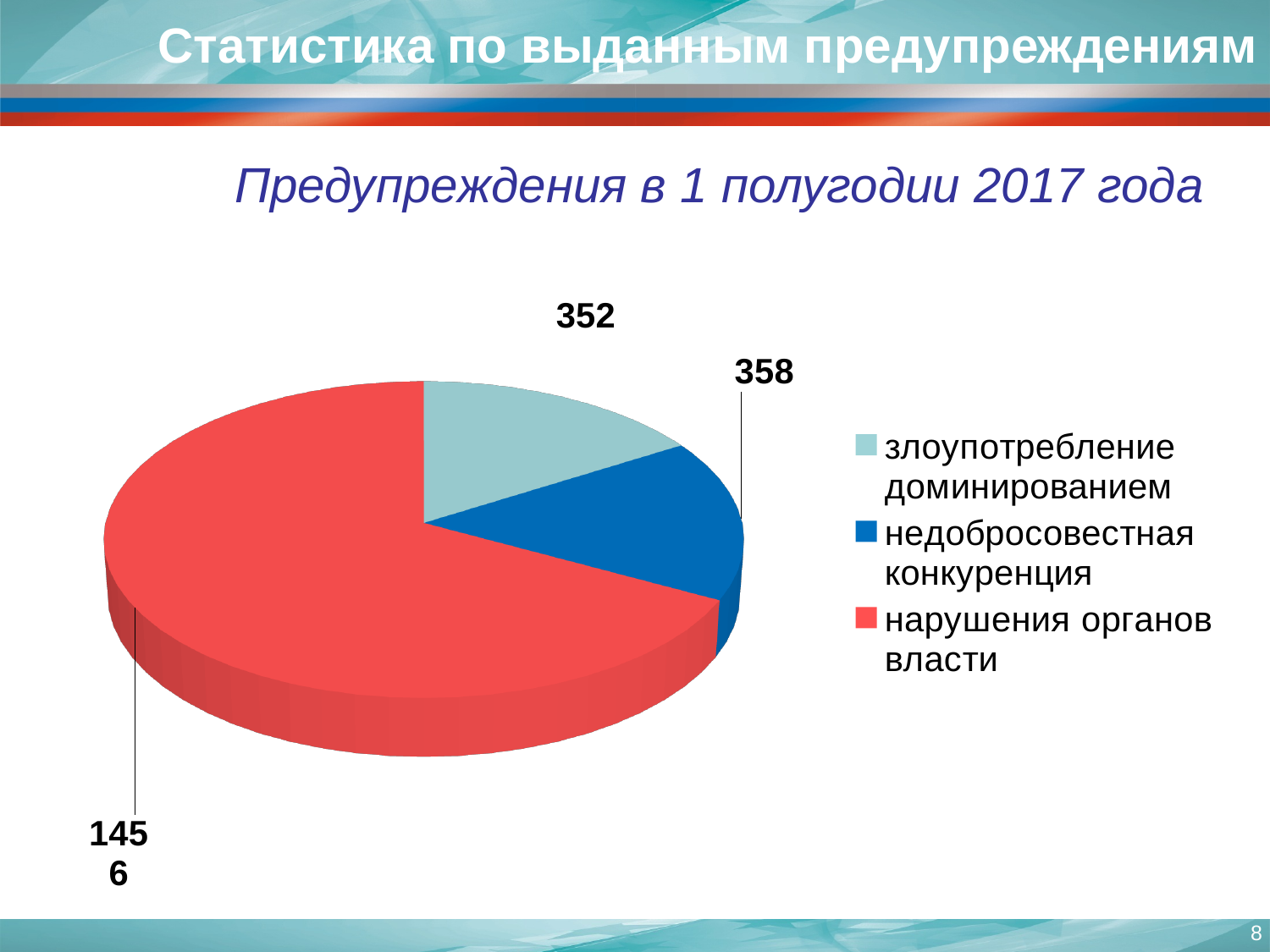
What is the value for недобросовестная конкуренция? 358 Which is larger: недобросовестная конкуренция or злоупотребление доминированием? недобросовестная конкуренция What is the value for нарушения органов власти? 1456 Which category has the largest slice of the pie? нарушения органов власти What is the value for злоупотребление доминированием? 352 What is the title of the chart? Предупреждения в 1 полугодии 2017 года Which category has the smallest value? злоупотребление доминированием How many entries does the legend list? 3 How many slices does the pie chart have? 3 What is the difference between the values for недобросовестная конкуренция and злоупотребление доминированием? 6 Which colour represents нарушения органов власти in the chart? Red What type of chart is shown on the slide? Pie chart